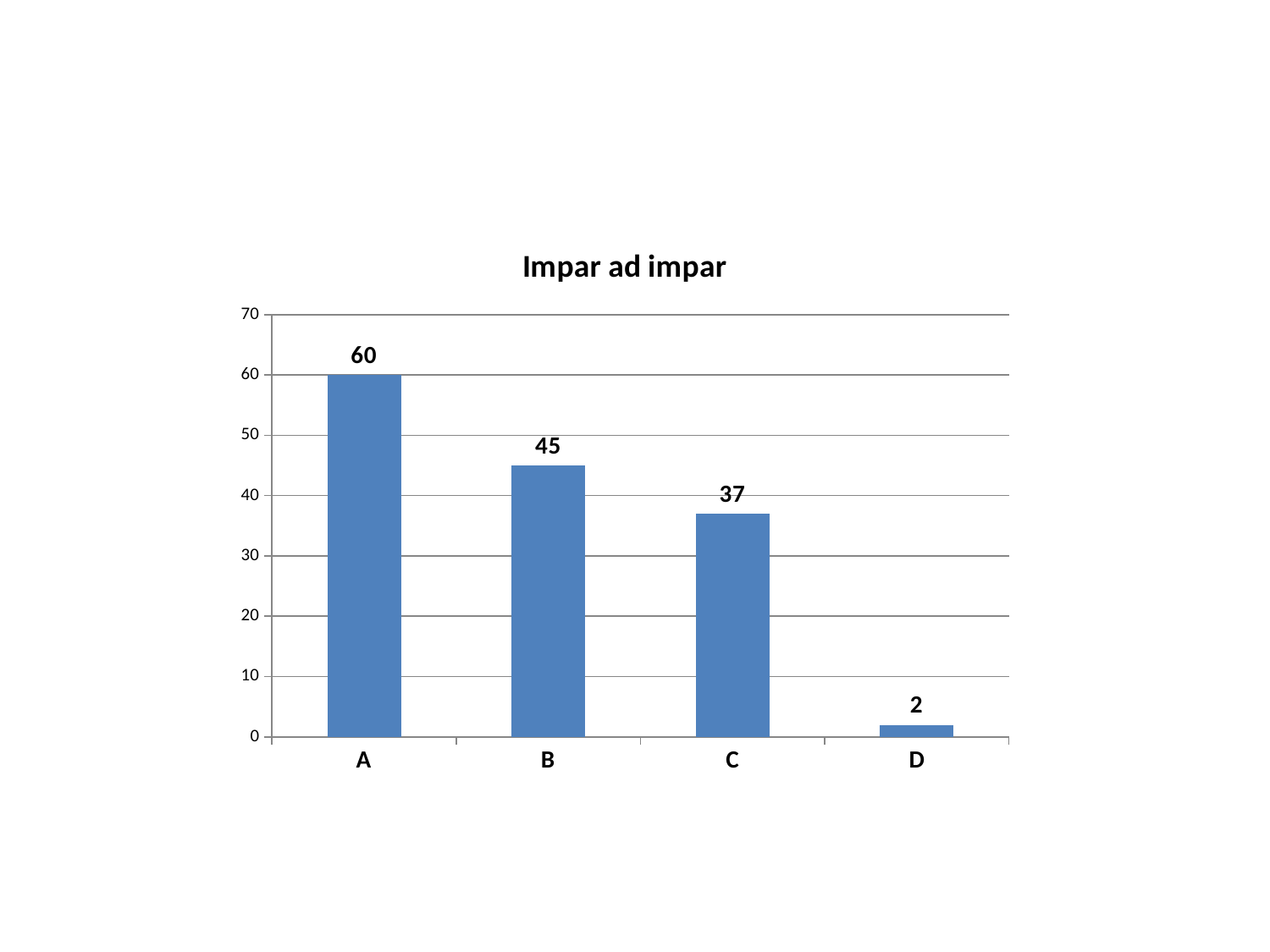
What is the value for category A? 60 What kind of chart is shown on the slide? Bar chart How many categories are shown on the chart? 4 What is the difference between the values for A and B? 15 Which is larger, the value for B or the value for C? B What is the value for category B? 45 What is the value for category C? 37 What is the value for category D? 2 Which category has the highest value? A Which category has the lowest value? D What is the title of the chart? Impar ad impar What is the difference between the values for C and D? 35